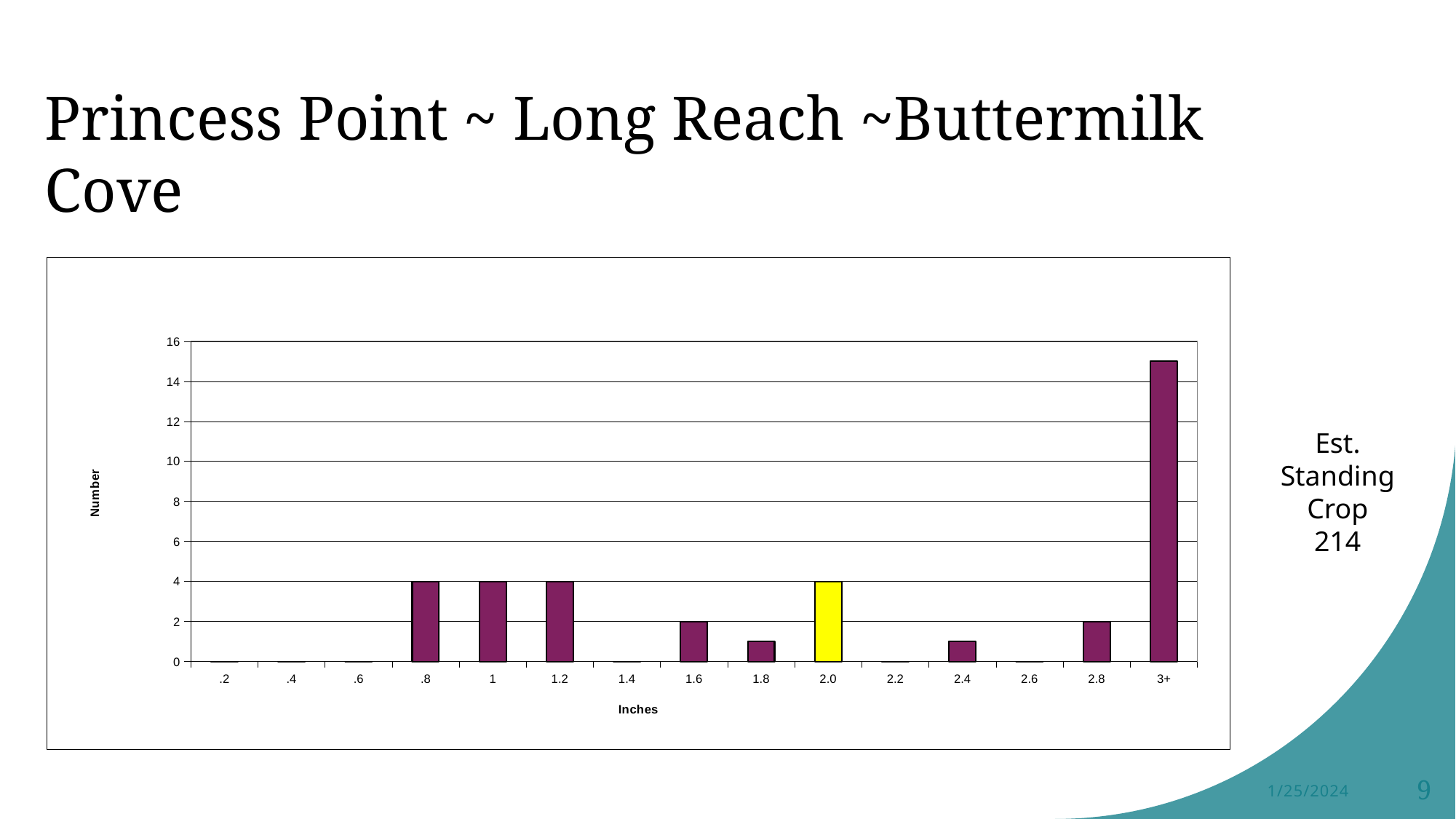
What is the number for the 2.8 inch category? 2 Which inch category has the highest number? 3+ What is the number for the 1.6 inch category? 2 How many inch categories are shown on the x axis? 15 What is the difference between the number for .8 inches and the number for 1.6 inches? 2 Which inch category is drawn with a yellow bar? 2.0 Is the value for the 1.8 inch category greater or less than 2? less What is the number for the .8 inch category? 4 What kind of chart is shown on the slide? bar chart What is the number for the 2.0 inch category? 4 Which is larger, the number for 3+ inches or the number for 2.0 inches? 3+ Is the value for the 3+ inch category greater or less than 14? greater